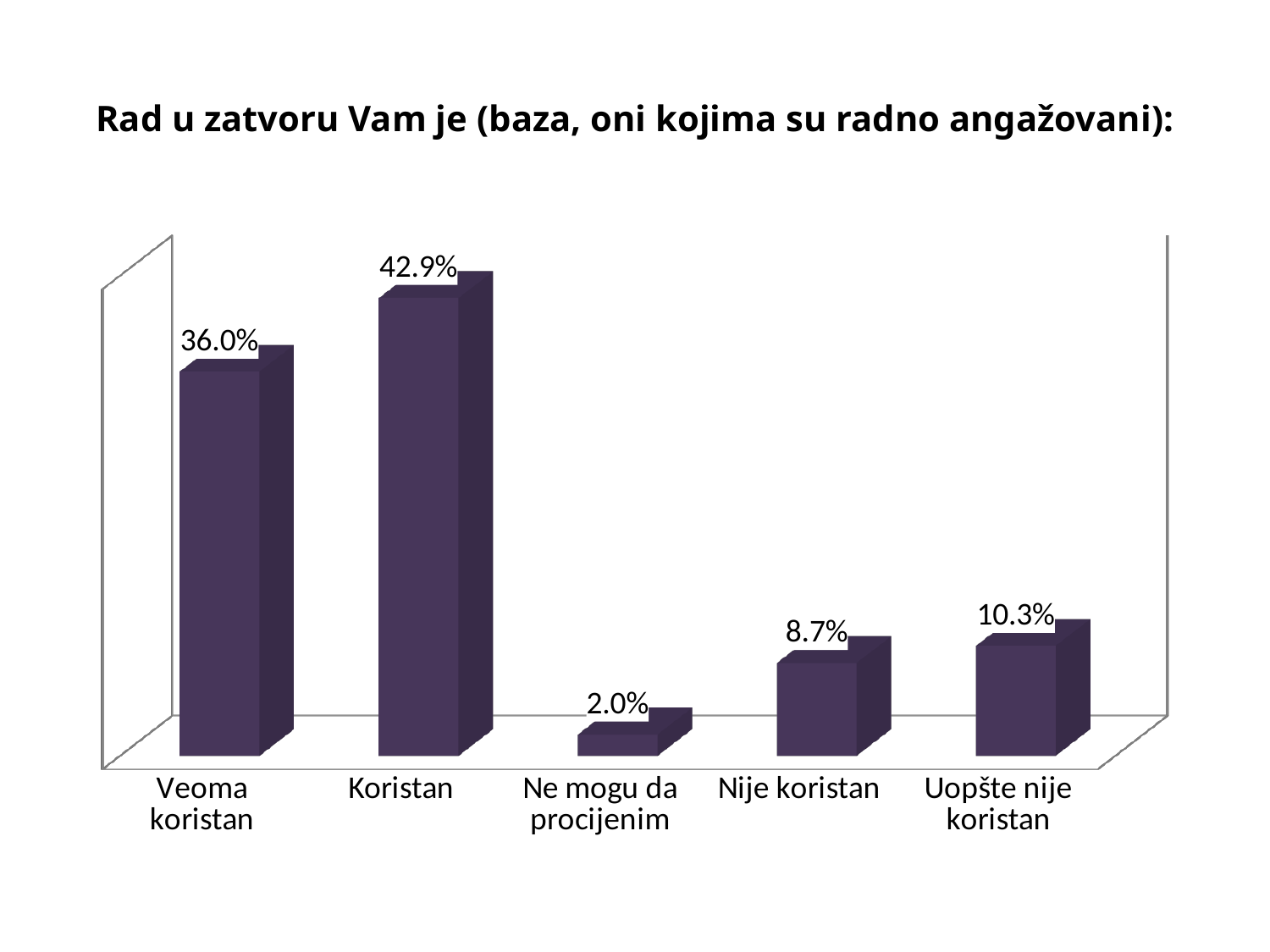
What is the value for "Koristan"? 42.9% What is the value for "Veoma koristan"? 36.0% What is the title of the chart? Rad u zatvoru Vam je (baza, oni kojima su radno angažovani): Which is larger, the value for "Nije koristan" or "Uopšte nije koristan"? Uopšte nije koristan What is the value for "Ne mogu da procijenim"? 2.0% What is the value for "Nije koristan"? 8.7% How many categories are shown on the chart? 5 Which category has the highest value? Koristan Which category has the lowest value? Ne mogu da procijenim What is the difference between the values for "Koristan" and "Veoma koristan"? 6.9% What is the value for "Uopšte nije koristan"? 10.3% What kind of chart is shown on the slide? Bar chart